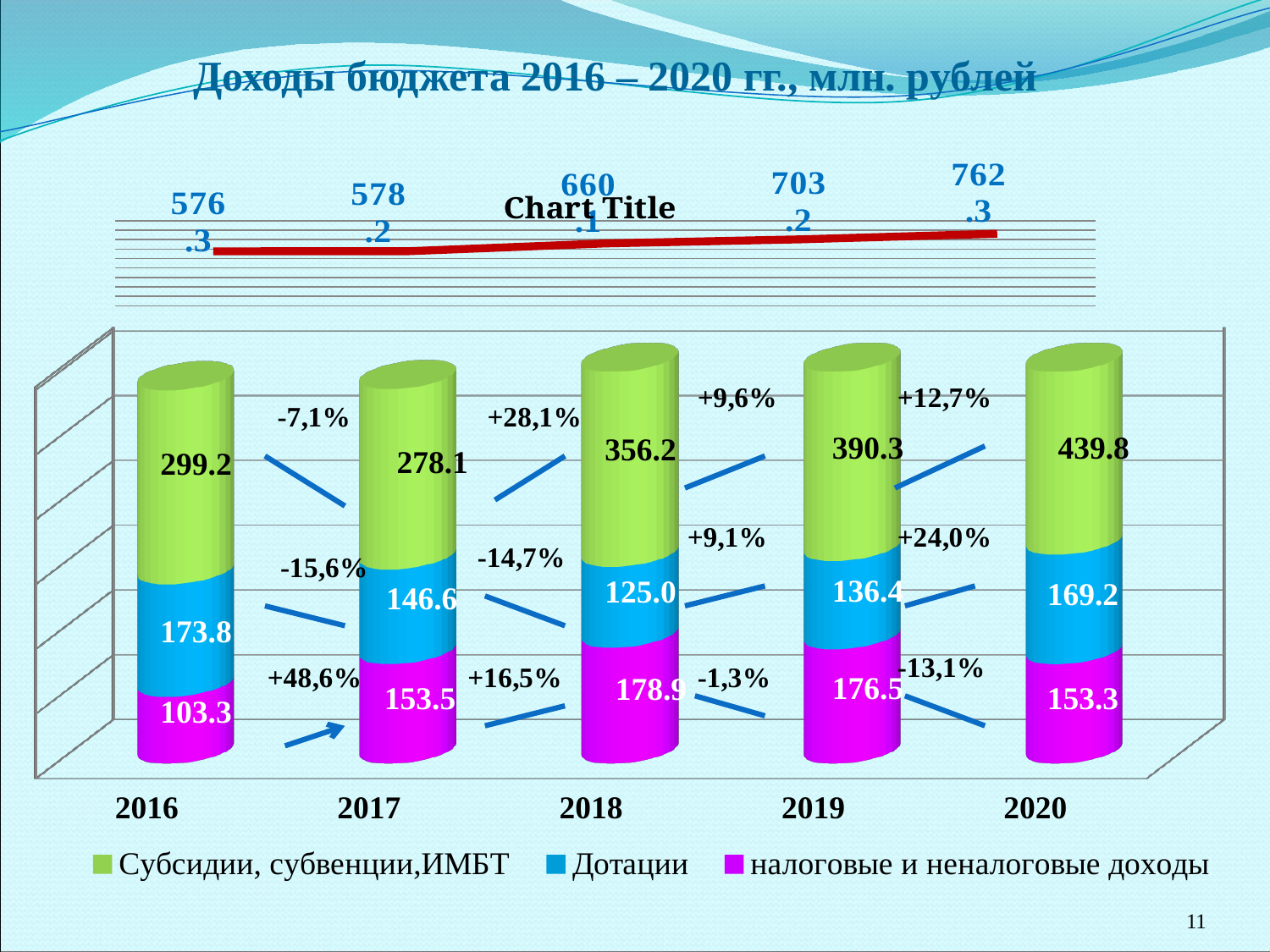
In the line chart at the top of the slide, do the values rise or fall from left to right? rise In the stacked bar chart, what is the value of Субсидии, субвенции,ИМБТ for 2020? 439.8 How many series does the legend of the stacked bar chart list? 3 In the stacked bar chart, what is the value of налоговые и неналоговые доходы for 2018? 178.9 In the stacked bar chart, which is larger: налоговые и неналоговые доходы for 2017 or for 2020? 2017 What is the total of the stacked bar for 2019 in the stacked bar chart? 703.2 In the line chart at the top of the slide, what is the value for the last point (2020)? 762.3 In the stacked bar chart, which year has the highest value for Субсидии, субвенции,ИМБТ? 2020 How many years are shown on the x axis of the stacked bar chart? 5 In the stacked bar chart, which year has the lowest value for налоговые и неналоговые доходы? 2016 In the stacked bar chart, what is the difference between the Дотации values for 2020 and 2018? 44.2 In the stacked bar chart, what is the value of Дотации for 2016? 173.8